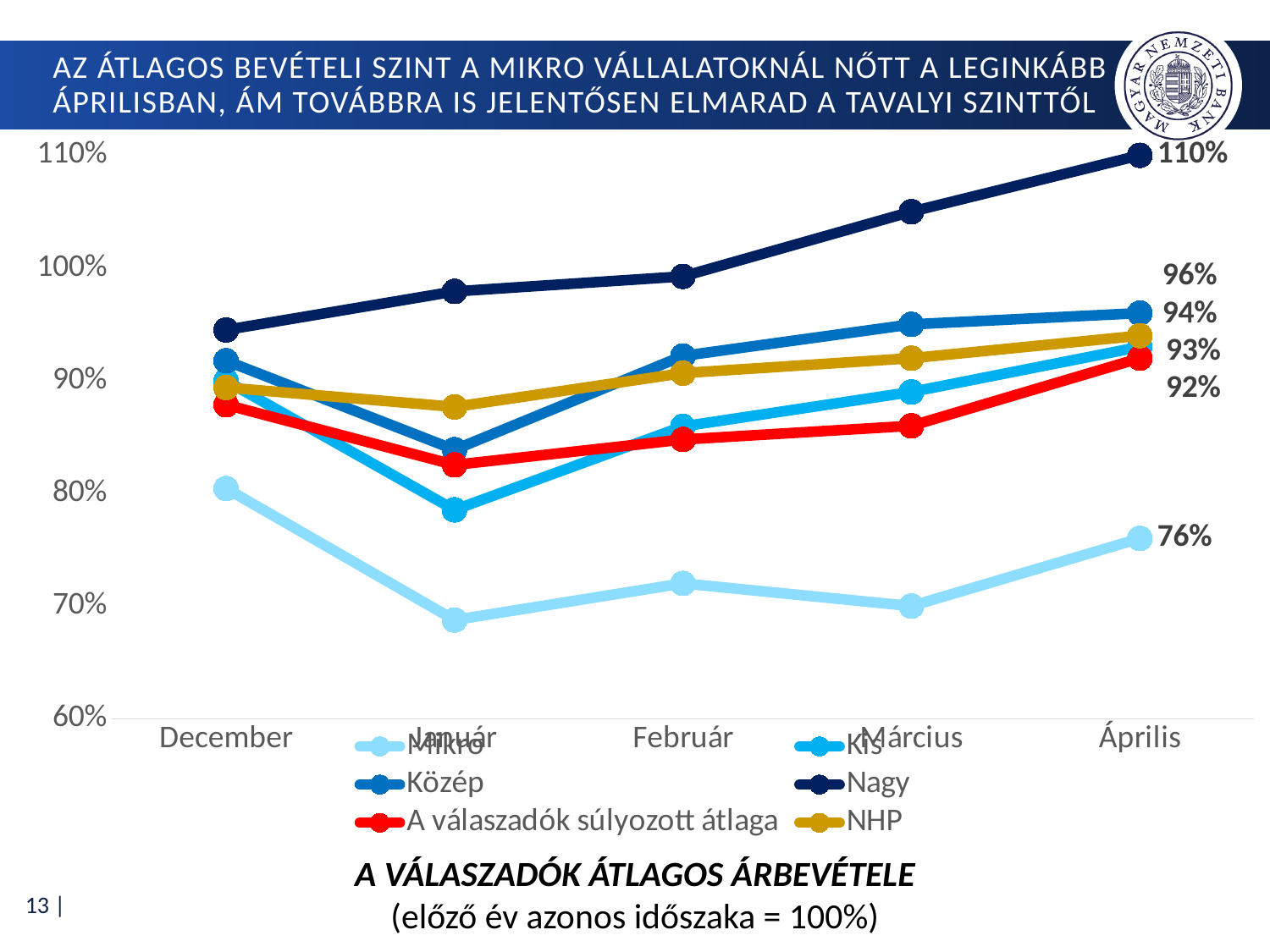
Is the value for Nagy in Március greater or less than 100%? greater What kind of chart is shown on the slide? line chart Which series has the lowest value in Április? Mikro Does the Nagy series rise or fall from December to Április? rise Is the value for Mikro in Január greater or less than 70%? less What is the value for Nagy in Április? 110% What is the value for Közép in Április? 96% Which series has the highest value in Április? Nagy How many months are shown on the x axis? 5 How many series does the legend list? 6 What is the difference between the Nagy and Mikro values in Április? 34 percentage points What is the value for Mikro in Április? 76%